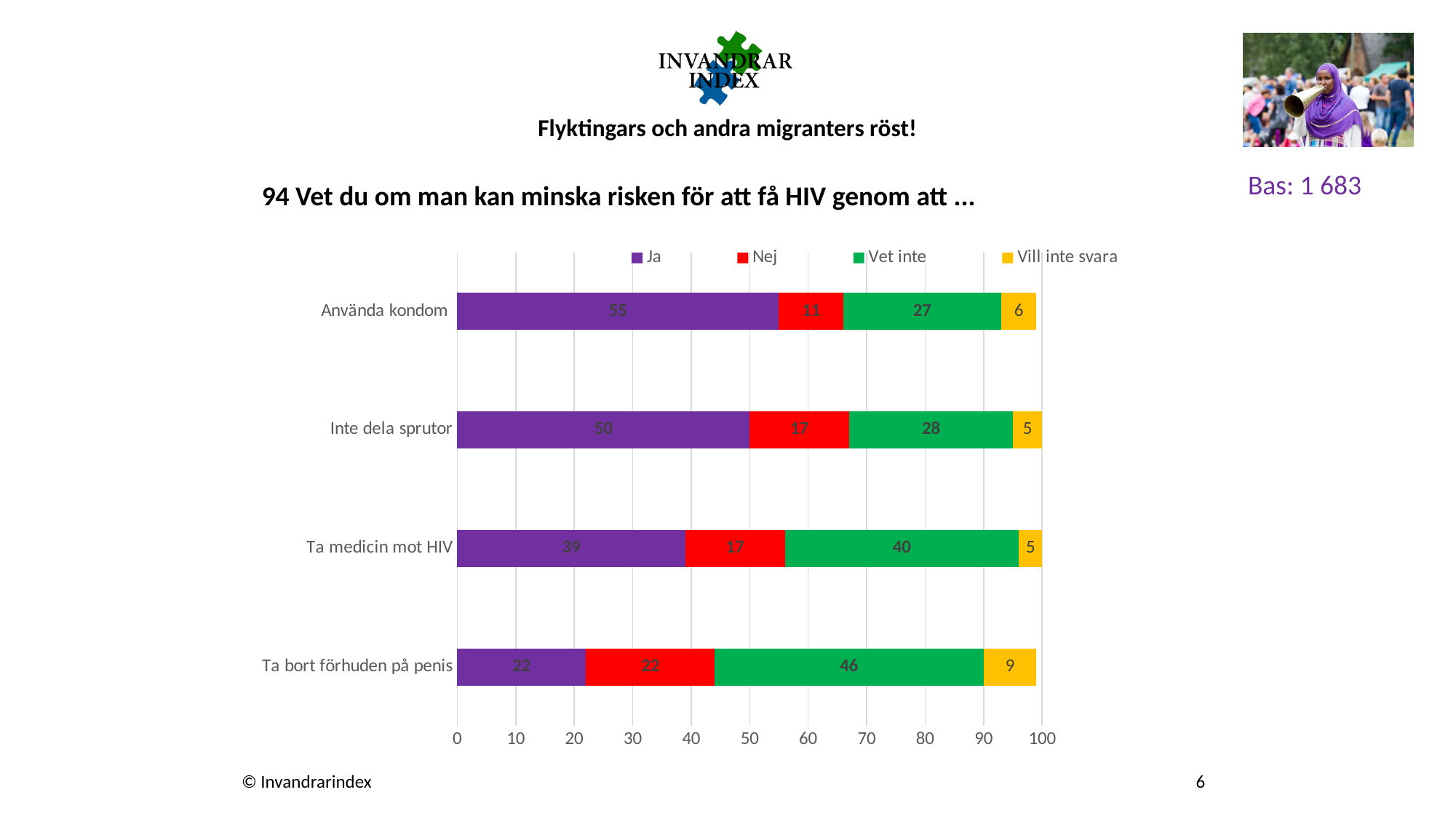
How many series does the legend list? 4 Which category has the highest value for "Ja"? Använda kondom What kind of chart is shown on the slide? Stacked bar chart What is the total of the stacked bar for "Ta medicin mot HIV"? 101 How many categories are shown on the chart? 4 What is the value for "Vet inte" for "Ta medicin mot HIV"? 40 What is the difference between the "Ja" values for "Använda kondom" and "Ta bort förhuden på penis"? 33 What is the value for "Nej" for "Ta bort förhuden på penis"? 22 What is the value for "Ja" for "Använda kondom"? 55 Which is larger: the "Nej" value for "Inte dela sprutor" or the "Nej" value for "Använda kondom"? Inte dela sprutor What is the value for "Vill inte svara" for "Inte dela sprutor"? 5 Which category has the lowest value for "Vet inte"? Använda kondom